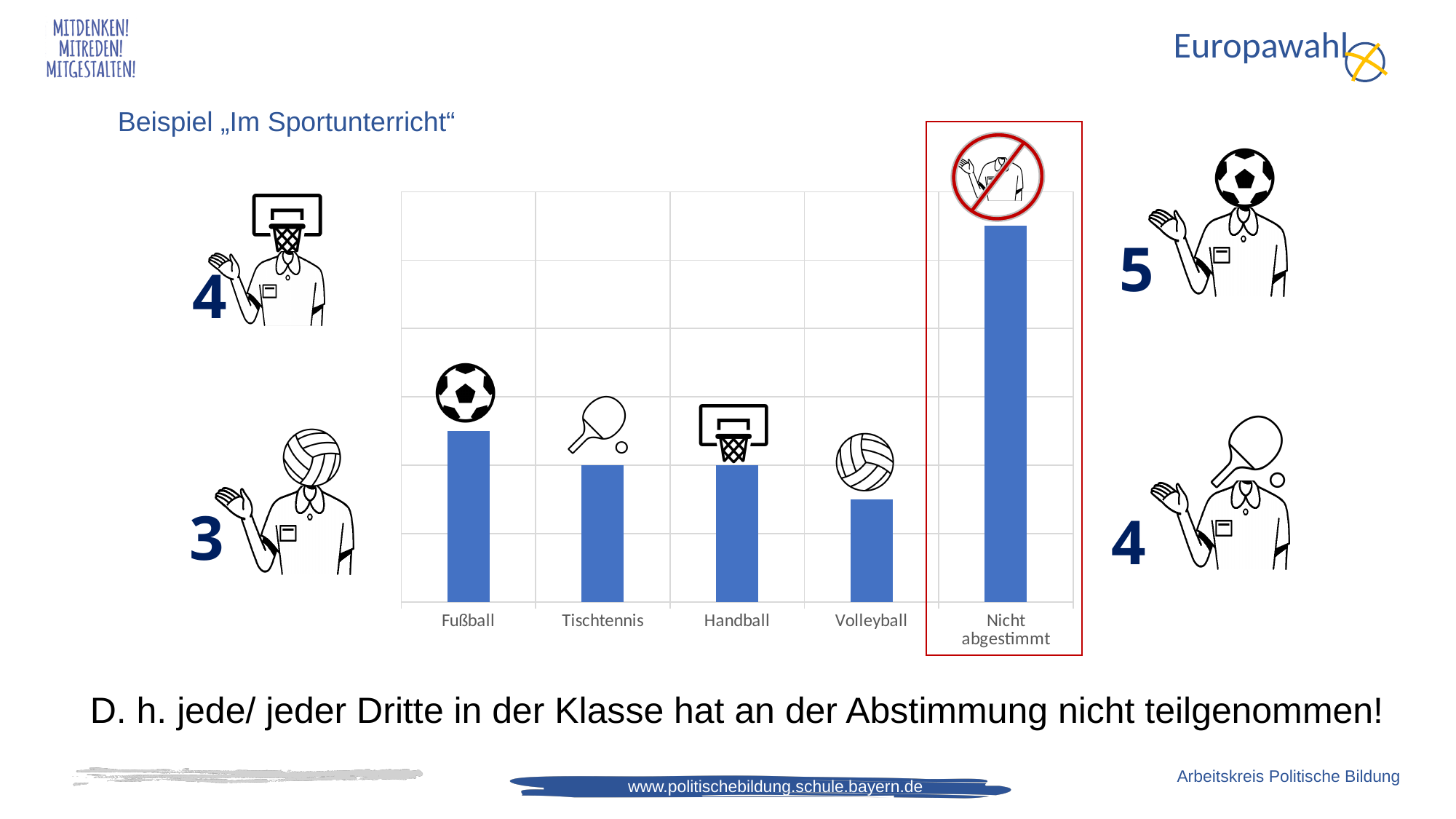
Which category has the highest bar in the chart? Nicht abgestimmt What kind of chart is shown on the slide? bar chart Which bar is taller, Tischtennis or Volleyball? Tischtennis What is the example title written above the chart? Beispiel „Im Sportunterricht“ Which bar is taller, Nicht abgestimmt or Fußball? Nicht abgestimmt Which bar is taller, Fußball or Volleyball? Fußball Which category on the chart is highlighted with a red box? Nicht abgestimmt Which of the sports categories (excluding Nicht abgestimmt) has the highest bar? Fußball How many categories are shown on the x axis of the chart? 5 Which category has the lowest bar in the chart? Volleyball